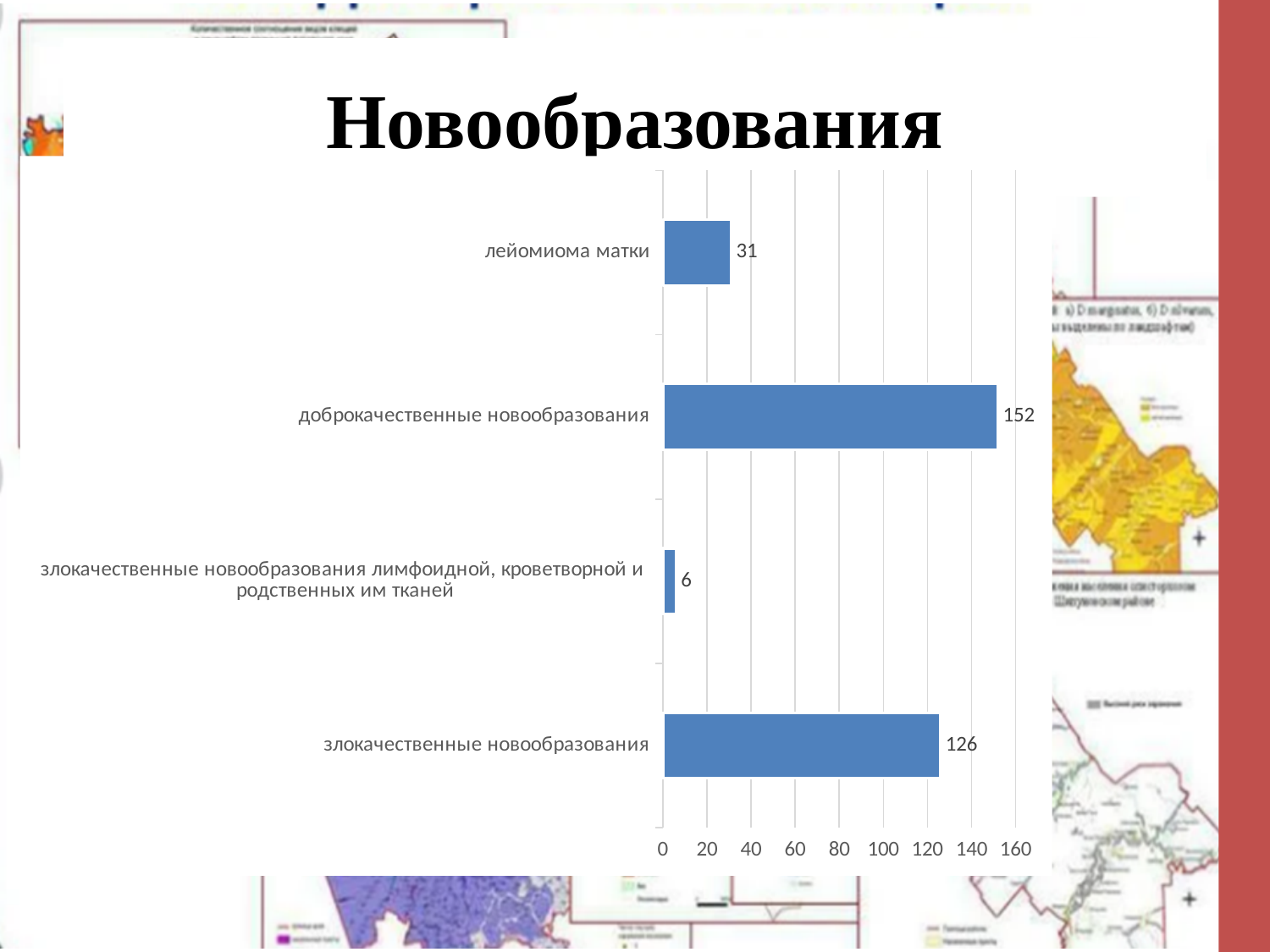
What is the value for злокачественные новообразования лимфоидной, кроветворной и родственных им тканей? 6 What is the difference between доброкачественные новообразования and злокачественные новообразования? 26 What is the value for лейомиома матки? 31 What is the value for доброкачественные новообразования? 152 What is the title of the slide? Новообразования Which category has the highest value? доброкачественные новообразования How many categories are shown in the chart? 4 What is the value for злокачественные новообразования? 126 Which is larger: лейомиома матки or злокачественные новообразования? злокачественные новообразования Which category has the lowest value? злокачественные новообразования лимфоидной, кроветворной и родственных им тканей Is the value for злокачественные новообразования greater or less than 100? greater What kind of chart is shown on the slide? bar chart